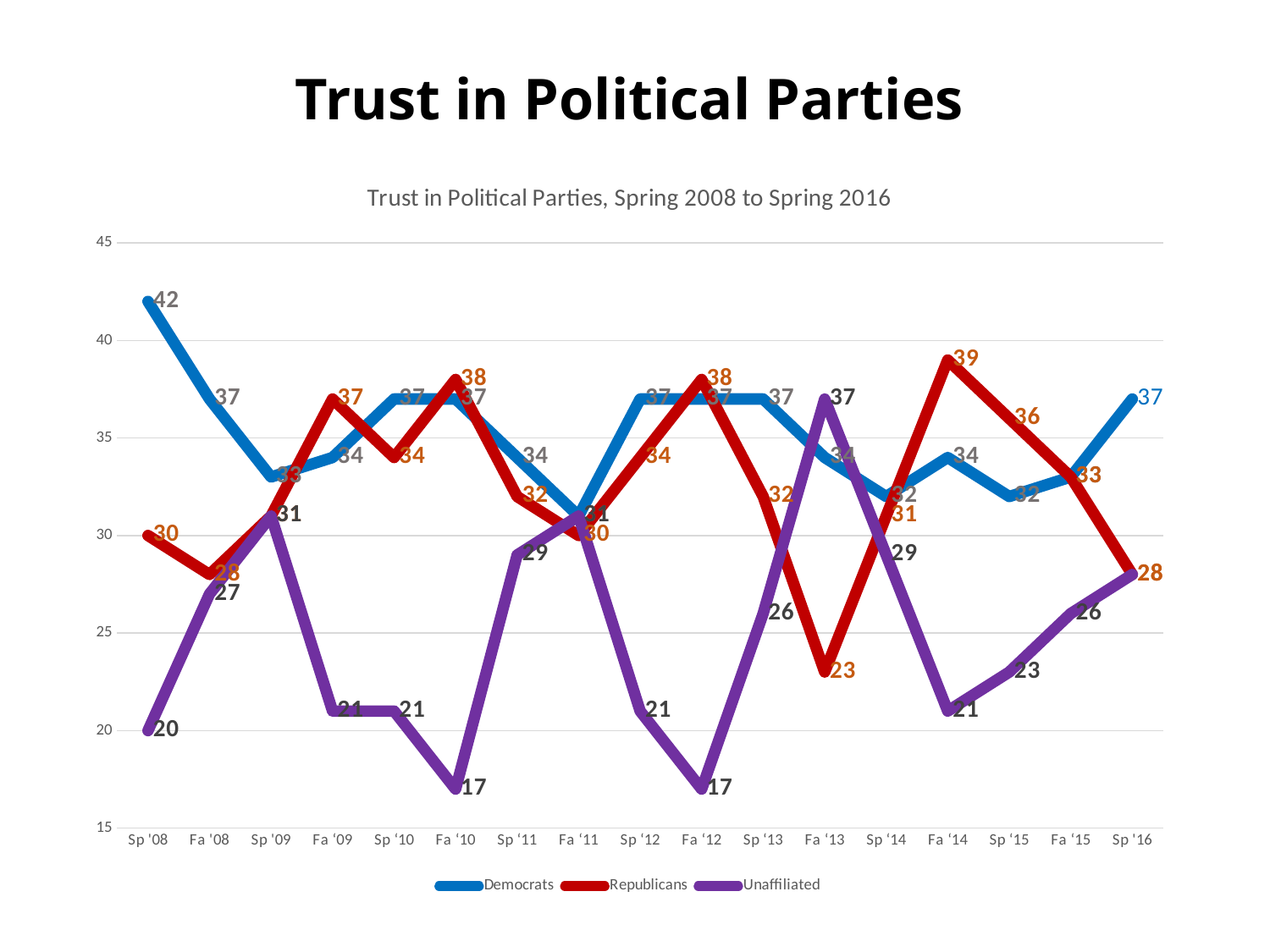
In which period does the Republicans series reach its lowest value? Fa '13 What is the value for Democrats in Sp '08? 42 How many series does the legend list? 3 What is the value for Unaffiliated in Fa '10? 17 What colour is the Democrats line? Blue What kind of chart is shown on the slide? Line chart How many time periods are shown on the x axis? 17 What is the value for Republicans in Fa '14? 39 In Fa '13, which is larger: the Republicans value or the Unaffiliated value? Unaffiliated In which period does the Republicans series reach its highest value? Fa '14 What is the difference between the Democrats and Republicans values in Sp '08? 12 What is the value for Unaffiliated in Sp '16? 28